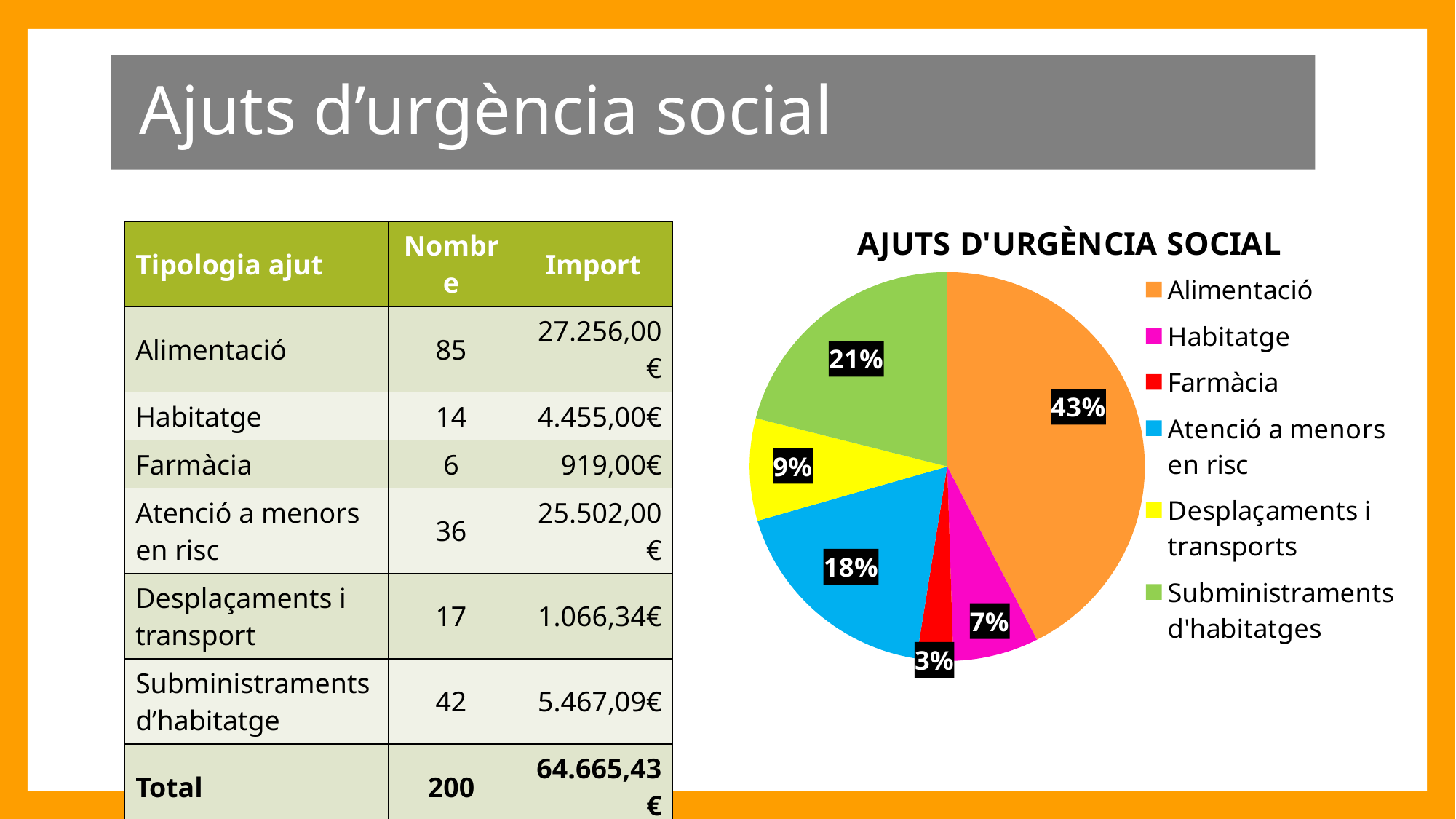
What is the title of the pie chart? AJUTS D'URGÈNCIA SOCIAL How many slices does the pie chart have? 6 What is the difference in percentage points between the Alimentació slice and the Subministraments d'habitatges slice? 22 Which category has the smallest slice in the pie chart? Farmàcia Which slice is larger in the pie chart, Habitatge or Desplaçaments i transports? Desplaçaments i transports What share of the pie chart does Farmàcia represent? 3% What kind of chart is shown on the slide? pie chart Which category has the largest slice in the pie chart? Alimentació What share of the pie chart does Subministraments d'habitatges represent? 21% What share of the pie chart does Atenció a menors en risc represent? 18% What colour is the Atenció a menors en risc slice in the pie chart? blue